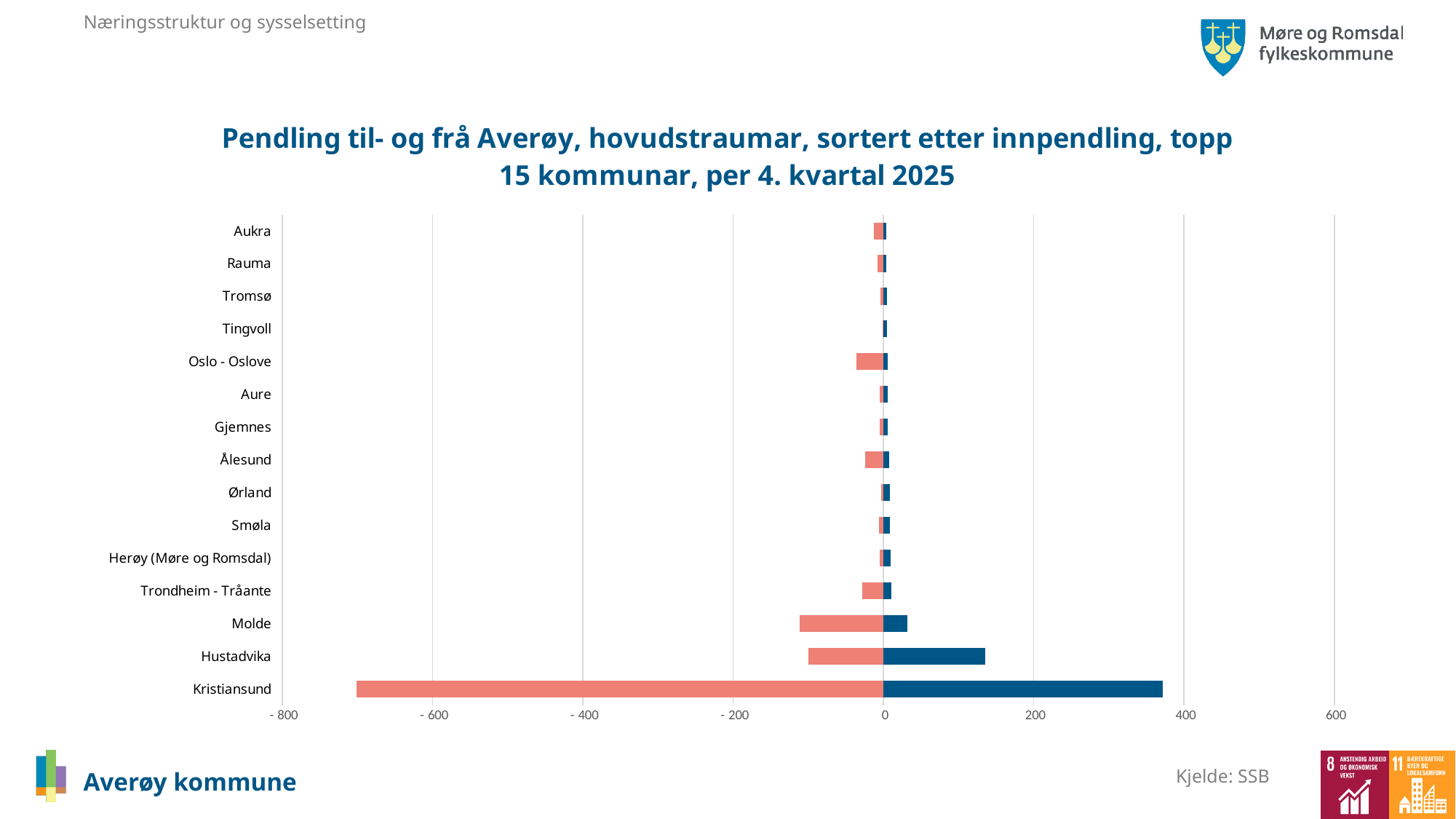
Which has the longer red (negative) bar, Oslo - Oslove or Aukra? Oslo - Oslove How many municipalities (categories) are listed on the chart? 15 Which has the larger blue (positive) bar, Hustadvika or Molde? Hustadvika Which municipality has the longest red (negative) bar? Kristiansund What is the title of the chart? Pendling til- og frå Averøy, hovudstraumar, sortert etter innpendling, topp 15 kommunar, per 4. kvartal 2025 Is the red (negative) value for Kristiansund greater or less than -600? less Is the red (negative) value for Molde greater or less than -200? greater Is the blue (positive) value for Hustadvika greater or less than 200? less What source is cited for the chart data? SSB What kind of chart is shown on the slide? bar chart Which municipality has the longest blue (positive) bar? Kristiansund